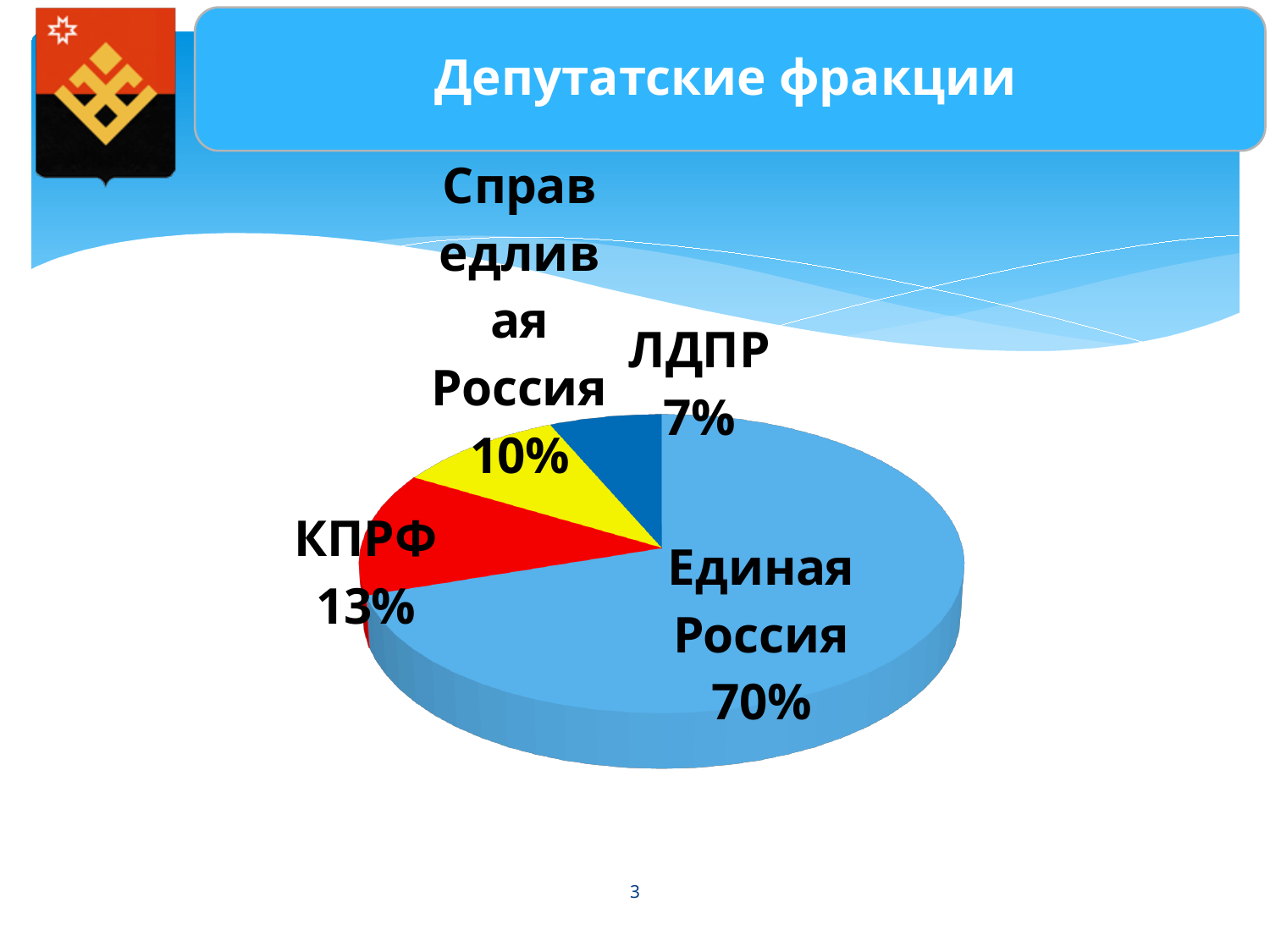
Which faction has the smallest slice of the pie? ЛДПР What is the difference between the shares of Единая Россия and КПРФ? 57% How many factions are shown in the pie chart? 4 Which is larger, the share of КПРФ or the share of Справедливая Россия? КПРФ What share of the pie does Единая Россия hold? 70% What kind of chart is shown on the slide? Pie chart What is the value shown for Справедливая Россия? 10% What is the title of the slide containing the chart? Депутатские фракции What is the value shown for КПРФ? 13% What is the value shown for ЛДПР? 7% Which faction has the largest slice of the pie? Единая Россия What is the difference between the shares of КПРФ and ЛДПР? 6%